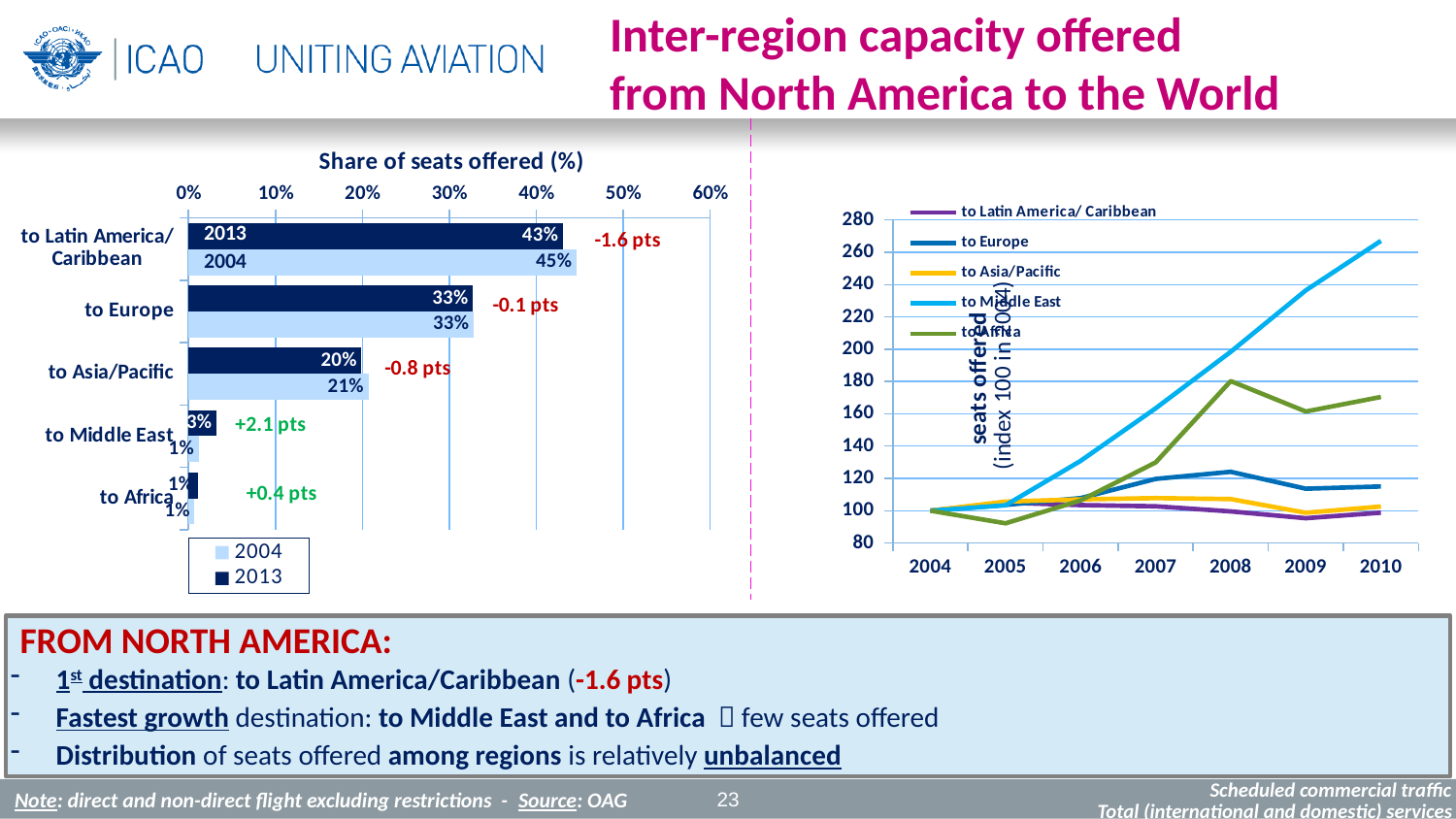
In the line chart on the right, which series has the highest value in 2010? to Middle East In the 'Share of seats offered (%)' bar chart, what is the 2013 share for 'to Latin America/ Caribbean'? 43% In the line chart on the right, is the 2010 value for 'to Middle East' greater or less than 240? greater In the 'Share of seats offered (%)' bar chart, is the 2013 share for 'to Europe' larger or smaller than the 2013 share for 'to Asia/Pacific'? larger In the 'Share of seats offered (%)' bar chart, what is the 2013 share for 'to Middle East'? 3% In the 'Share of seats offered (%)' bar chart, which destination has the lowest 2013 share? to Africa How many series does the legend of the 'Share of seats offered (%)' bar chart list? 2 How many series does the legend of the line chart on the right list? 5 In the 'Share of seats offered (%)' bar chart, what is the 2004 share for 'to Asia/Pacific'? 21% In the 'Share of seats offered (%)' bar chart, which destination has the highest 2013 share? to Latin America/ Caribbean What type of chart is the chart on the left of the slide? bar chart In the 'Share of seats offered (%)' bar chart, what is the difference between the 2004 and 2013 shares for 'to Latin America/ Caribbean' as labelled on the chart? -1.6 pts